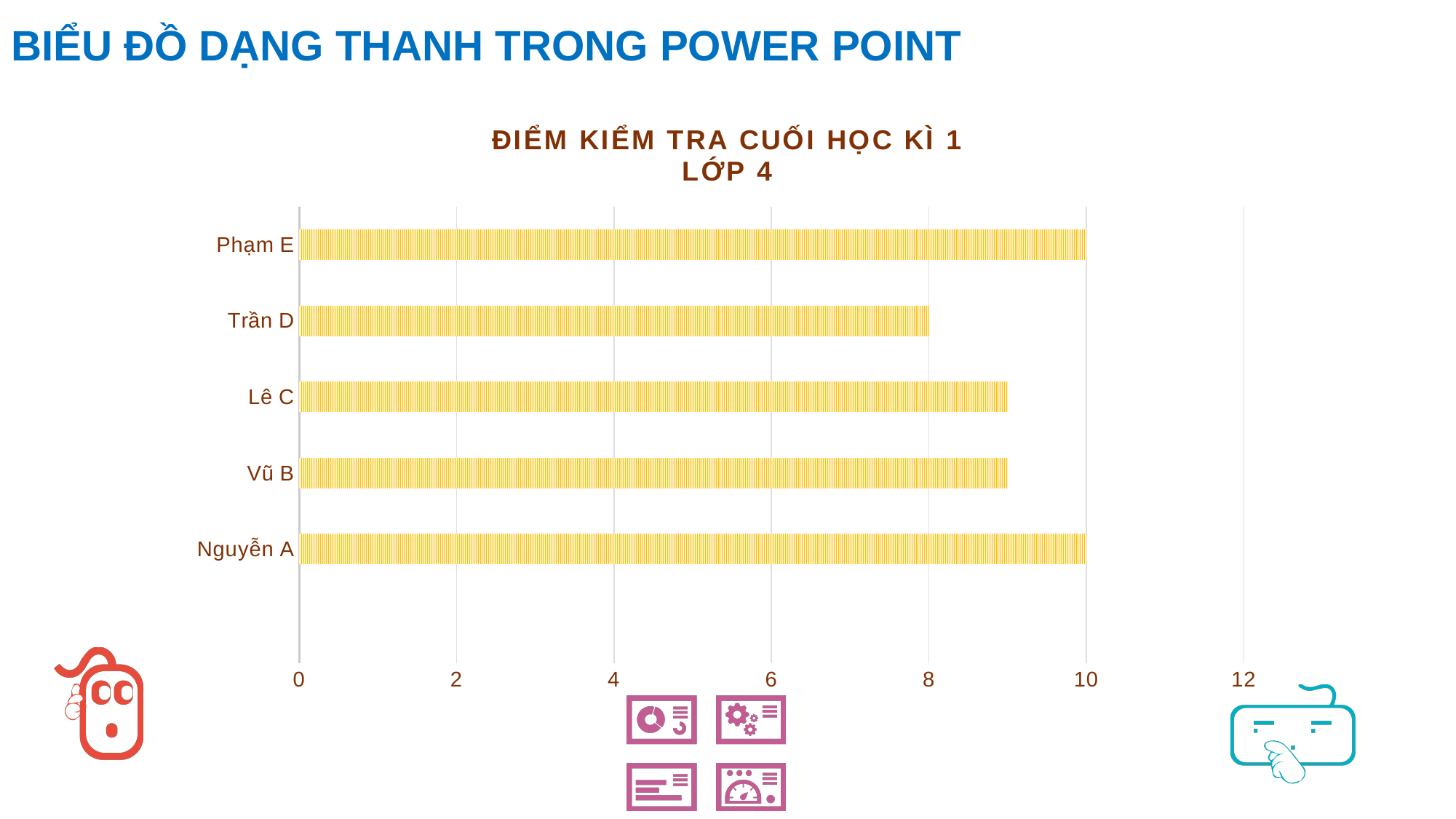
Is the value for Trần D greater or less than 6? greater Which is larger, the value for Phạm E or the value for Trần D? Phạm E What is the difference between the values for Phạm E and Trần D? 2 How many students (categories) are shown in the chart? 5 Which student has the lowest value? Trần D Is the value for Lê C greater or less than 8? greater Is the value for Vũ B greater or less than 10? less What is the value for Phạm E? 10 What kind of chart is shown on the slide? bar chart What is the value for Trần D? 8 What is the value for Nguyễn A? 10 What is the title of the chart? ĐIỂM KIỂM TRA CUỐI HỌC KÌ 1 LỚP 4